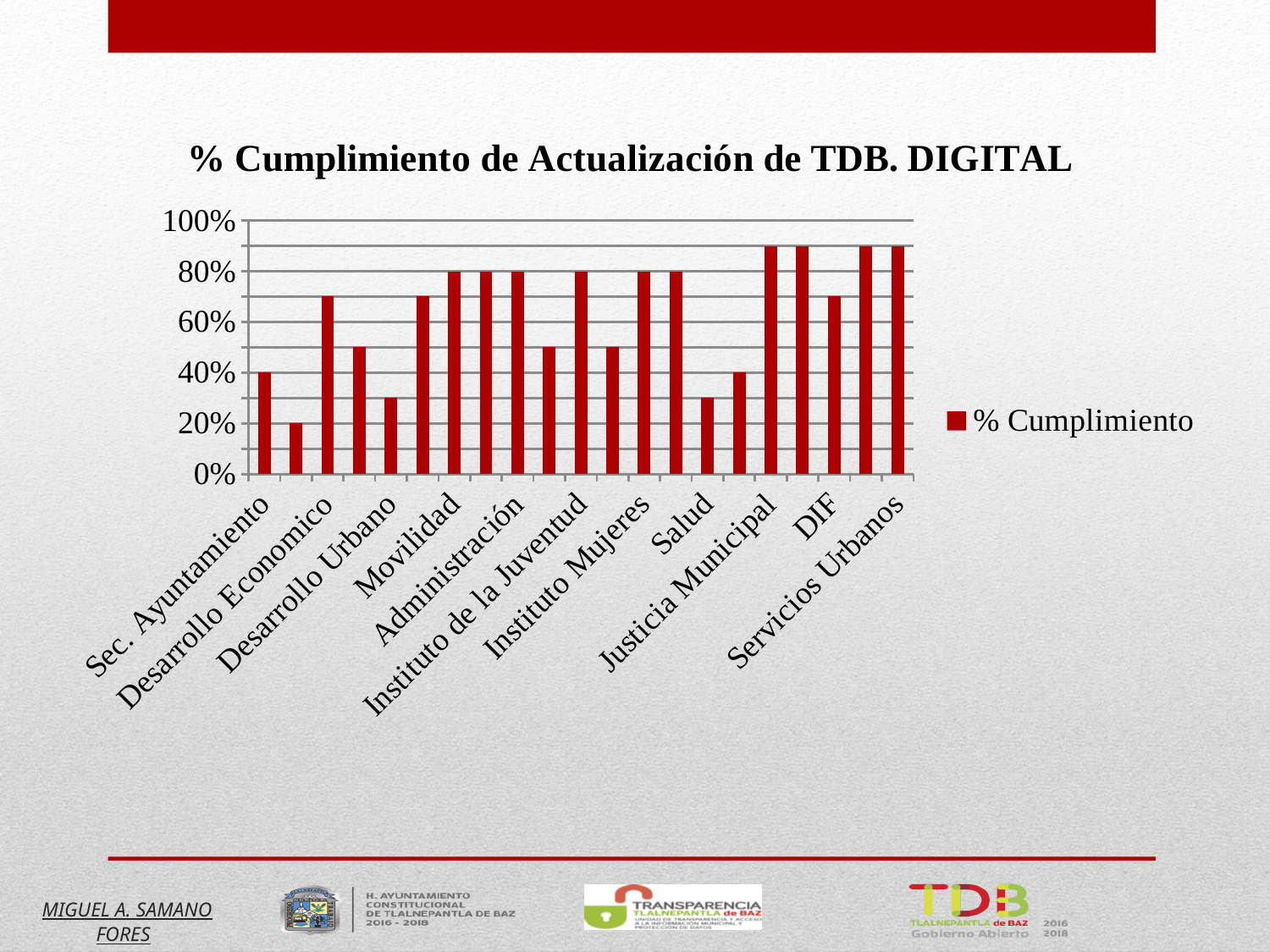
Is the value for Justicia Municipal greater or less than 80%? greater Is the value for Desarrollo Urbano greater or less than 40%? less What is the value for Instituto Mujeres? 80% How many bars are plotted in the chart? 21 What is the difference between the value for Administración and the value for Sec. Ayuntamiento? 40% What is the value for Sec. Ayuntamiento? 40% What is the title of the chart? % Cumplimiento de Actualización de TDB. DIGITAL What is the value for Movilidad? 80% What type of chart is shown on the slide? bar chart How many series does the legend list? 1 What is the name of the series shown in the legend? % Cumplimiento Which is larger, the value for Movilidad or the value for Sec. Ayuntamiento? Movilidad